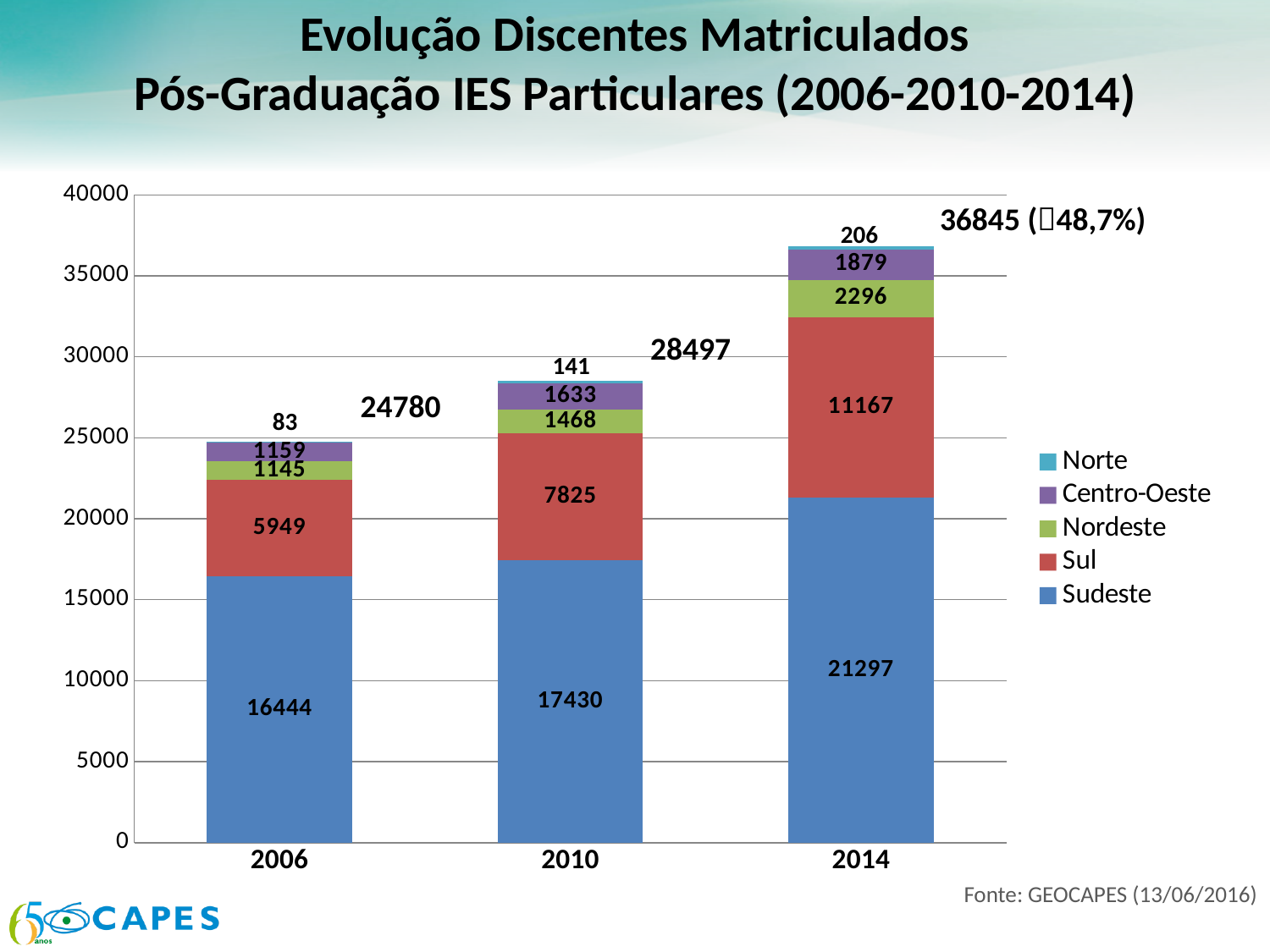
What is the total of the stacked bar for 2010? 28497 Do the total values rise or fall from 2006 to 2014? rise What is the value for Norte in 2006? 83 Which is larger in 2006: Nordeste or Centro-Oeste? Centro-Oeste What type of chart is shown on the slide? stacked bar chart What is the value for Sudeste in 2014? 21297 What is the difference between the Sul values for 2014 and 2006? 5218 How many series does the legend list? 5 What is the value for Sul in 2010? 7825 Which region has the lowest value in 2014? Norte How many years (categories) are shown on the x axis? 3 Which year has the highest total of enrolled students? 2014